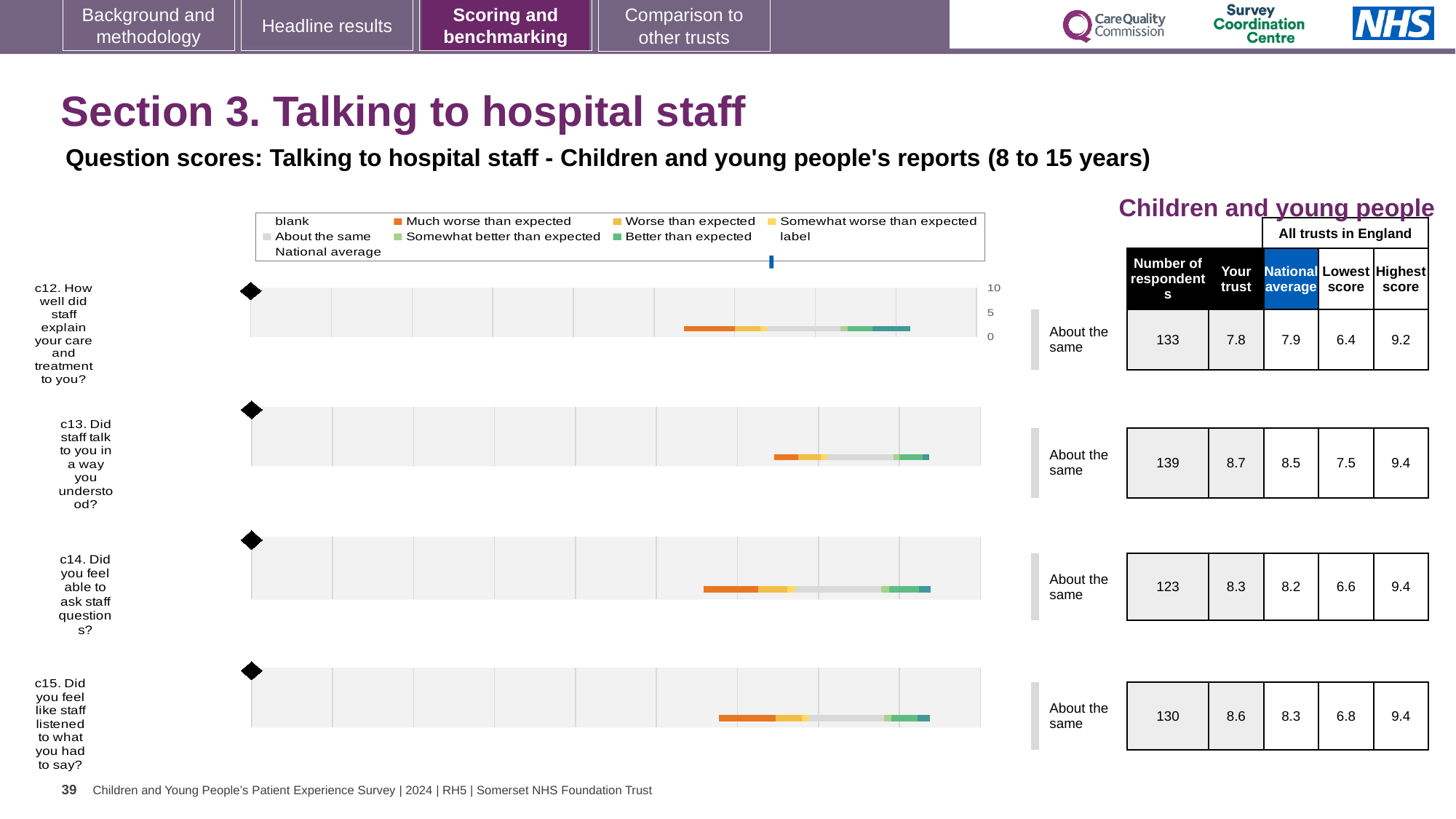
How many question charts (c12 to c15) are shown on the slide? 4 In the table beside the c12 chart, what is the 'Your trust' score? 7.8 In the table beside the c14 chart, how many respondents are there? 123 For c15, what is the difference between the 'Your trust' score and the national average? 0.3 What kind of chart is used for each question (c12 to c15) on the slide? Bar chart Which question (c12 to c15) has the lowest 'Your trust' score? c12 For c14, which is larger: the 'Your trust' score or the national average? Your trust In the table beside the c12 chart, what is the lowest score among all trusts in England? 6.4 In the table beside the c13 chart, what is the national average score? 8.5 Which legend entry is shown in grey? About the same Which legend entry is shown in orange? Much worse than expected Which question (c12 to c15) has the highest 'Your trust' score? c13